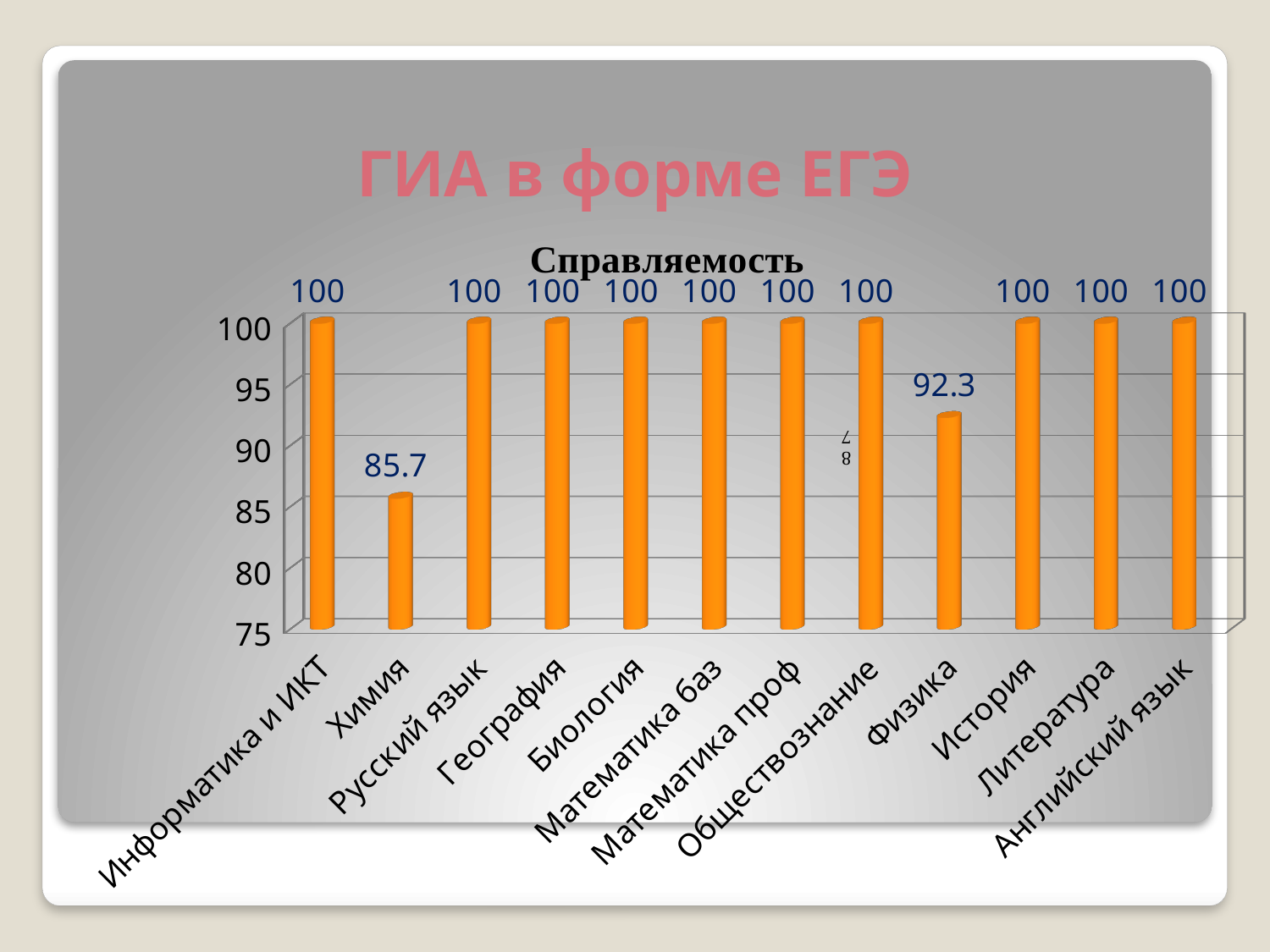
What is the difference between the values for История and Физика? 7.7 How many categories are shown on the x axis? 12 What is the title of the chart? Справляемость Which is larger, the value for Физика or the value for Химия? Физика Is the value for Физика greater or less than 90? greater What is the value for Информатика и ИКТ? 100 What kind of chart is shown? bar chart Which category has the lowest value? Химия What is the value for Физика? 92.3 What is the value for Химия? 85.7 What is the difference between the values for Физика and Химия? 6.6 Is the value for Химия greater or less than 90? less